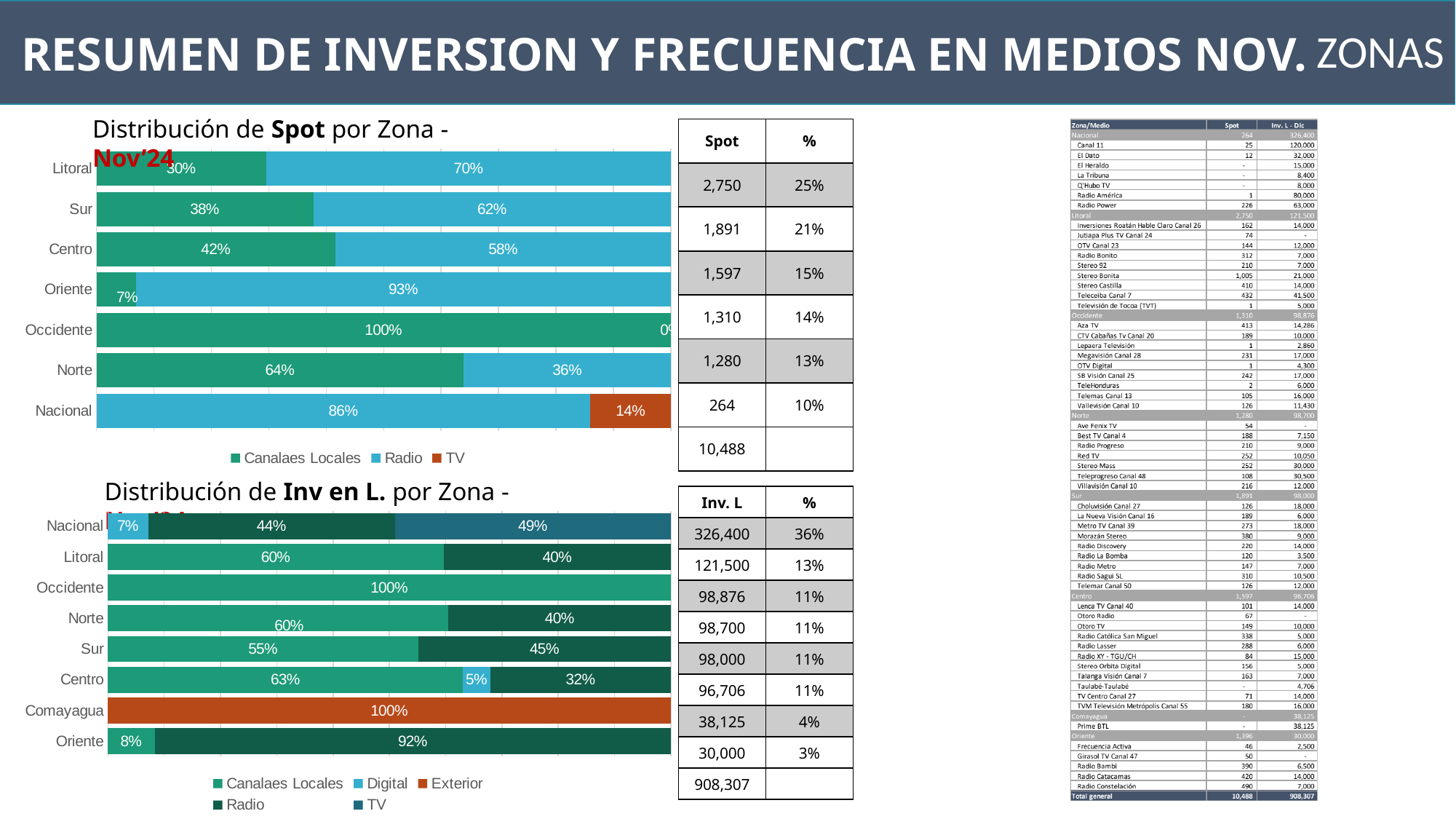
In the 'Distribución de Spot por Zona' chart, which zone has the highest Canalaes Locales share? Occidente In the 'Distribución de Spot por Zona' chart, how many zones are shown? 7 In the 'Distribución de Inv en L. por Zona' chart, which is larger: the Radio share for Sur or the Radio share for Centro? Sur In the 'Distribución de Spot por Zona' chart, what is the difference between the Radio shares of Litoral and Sur? 8% In the 'Distribución de Spot por Zona' chart, what is the TV share for Nacional? 14% In the 'Distribución de Inv en L. por Zona' chart, what is the Digital share for Centro? 5% In the 'Distribución de Spot por Zona' chart, what is the Radio share for Oriente? 93% In the 'Distribución de Inv en L. por Zona' chart, how many series does the legend list? 5 In the 'Distribución de Inv en L. por Zona' chart, what is the TV share for Nacional? 49% What kind of chart is 'Distribución de Inv en L. por Zona'? Stacked bar chart In the 'Distribución de Spot por Zona' chart, which zone has the lowest Canalaes Locales share? Oriente In the 'Distribución de Spot por Zona' chart, what is the Canalaes Locales share for Norte? 64%